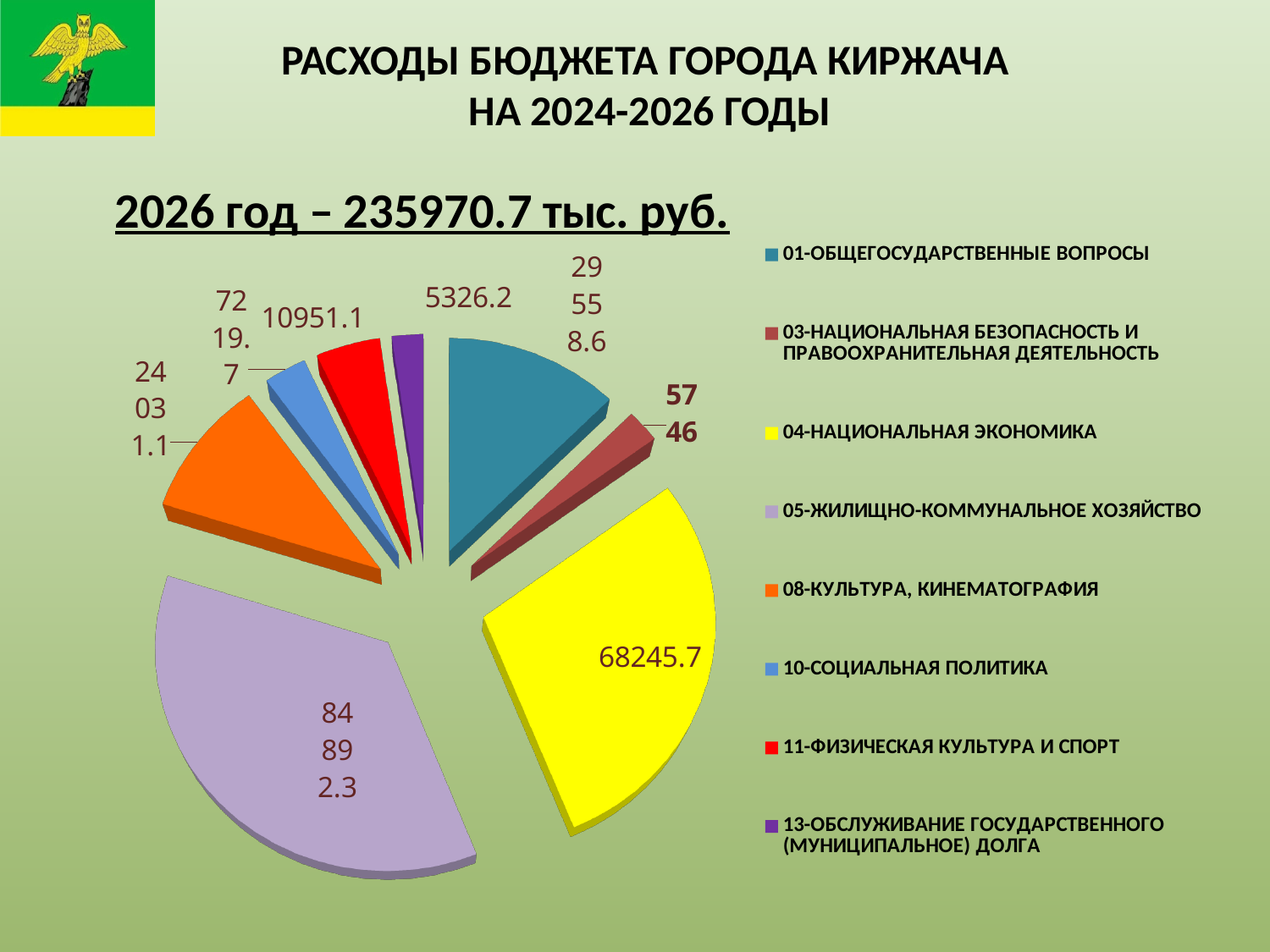
What is the value for 04-НАЦИОНАЛЬНАЯ ЭКОНОМИКА? 68245.7 What kind of chart is shown on the slide? Pie chart What is the value for 05-ЖИЛИЩНО-КОММУНАЛЬНОЕ ХОЗЯЙСТВО? 84892.3 What total for 2026 is stated above the chart? 235970.7 тыс. руб. What is the value for 11-ФИЗИЧЕСКАЯ КУЛЬТУРА И СПОРТ? 10951.1 What is the value for 13-ОБСЛУЖИВАНИЕ ГОСУДАРСТВЕННОГО (МУНИЦИПАЛЬНОЕ) ДОЛГА? 5326.2 What colour is the slice for 04-НАЦИОНАЛЬНАЯ ЭКОНОМИКА? Yellow Which is larger: 04-НАЦИОНАЛЬНАЯ ЭКОНОМИКА or 08-КУЛЬТУРА, КИНЕМАТОГРАФИЯ? 04-НАЦИОНАЛЬНАЯ ЭКОНОМИКА What is the difference between the values for 04-НАЦИОНАЛЬНАЯ ЭКОНОМИКА and 11-ФИЗИЧЕСКАЯ КУЛЬТУРА И СПОРТ? 57294.6 How many categories does the pie chart have? 8 Which category has the smallest slice of the pie? 13-ОБСЛУЖИВАНИЕ ГОСУДАРСТВЕННОГО (МУНИЦИПАЛЬНОЕ) ДОЛГА Which category has the largest slice of the pie? 05-ЖИЛИЩНО-КОММУНАЛЬНОЕ ХОЗЯЙСТВО